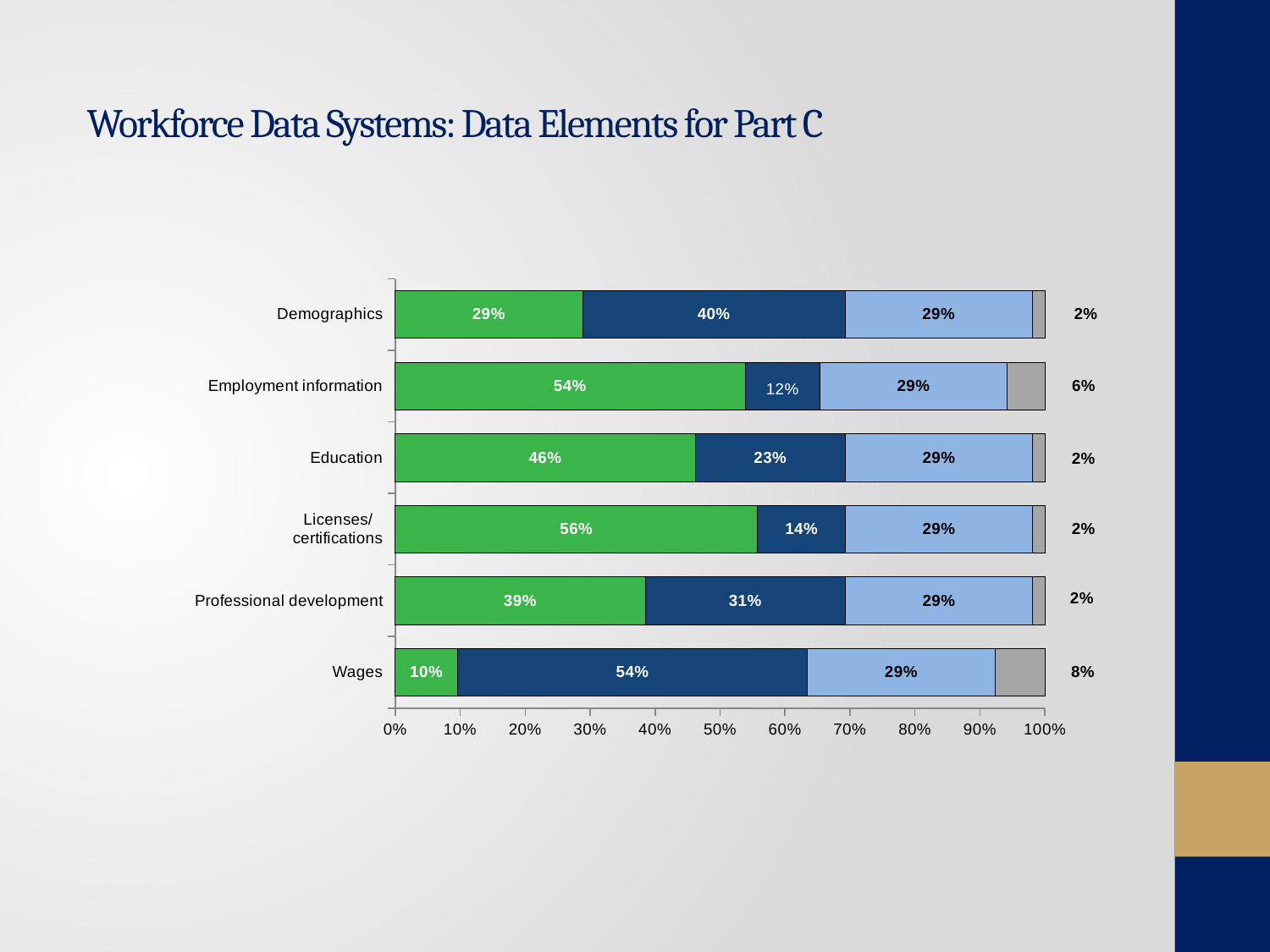
Which category has the largest gray segment? Wages What is the value of the green segment for Licenses/certifications? 56% What is the difference between the green segment for Employment information and the green segment for Demographics? 25 percentage points How many categories are plotted on the chart? 6 Which category has the largest green segment? Licenses/certifications What is the value of the dark blue segment for Wages? 54% What is the value of the gray segment for Employment information? 6% What kind of chart is shown on the slide? Stacked bar chart Which is larger: the dark blue segment for Demographics or the dark blue segment for Education? Demographics Which category has the smallest green segment? Wages How many coloured segments make up each bar? 4 What is the value of the light blue segment for Education? 29%